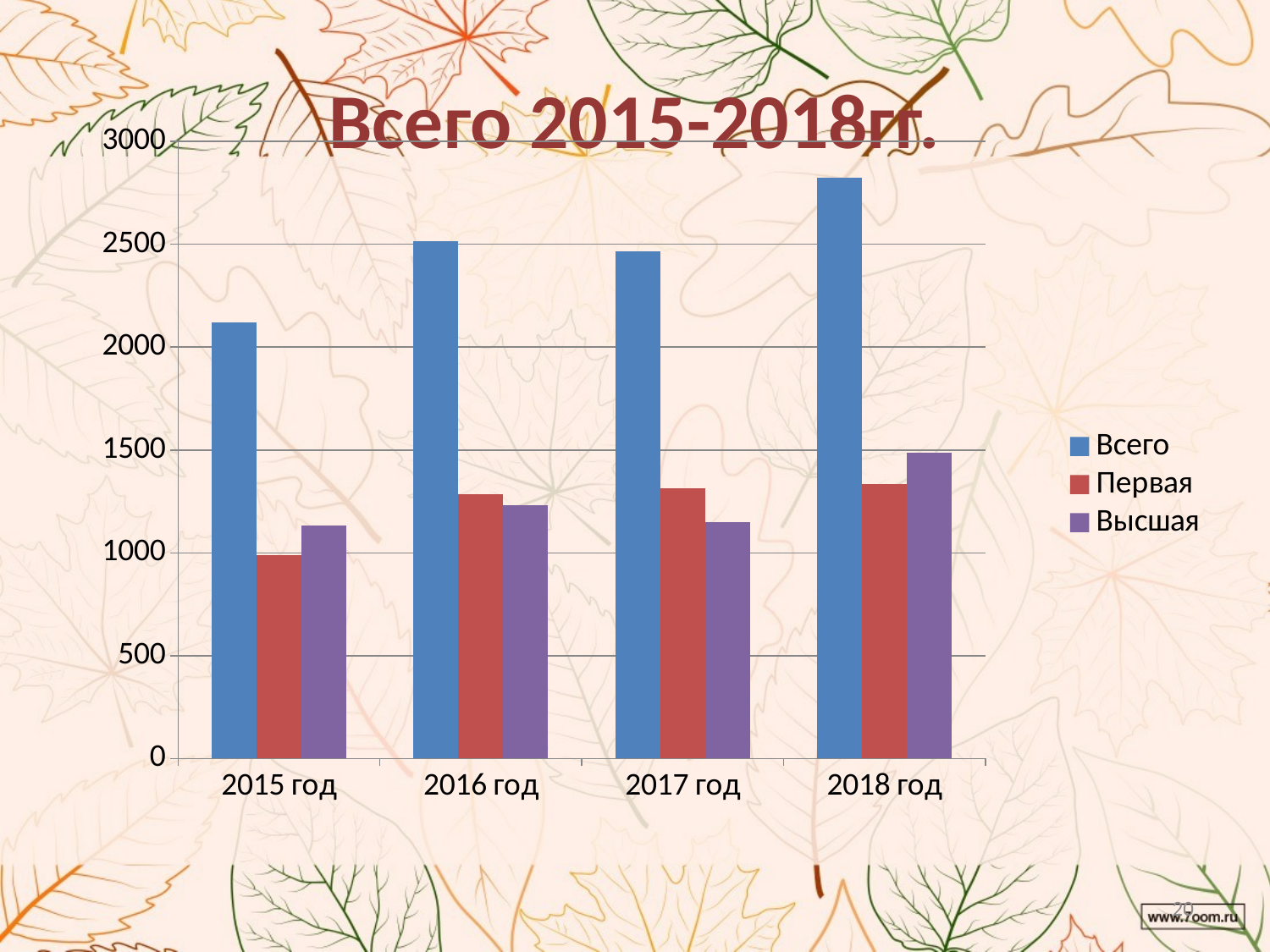
What is the title of the chart? Всего 2015-2018гг. Is the value for Всего in 2015 год greater or less than 2000? greater What kind of chart is shown on the slide? bar chart Which series is shown in blue? Всего How many series does the legend list? 3 In which year is the value for Всего the highest? 2018 год How many year categories are shown on the x axis? 4 In which year is the value for Всего the lowest? 2015 год In which year is the value for Высшая the highest? 2018 год In 2015 год, which is larger: Первая or Высшая? Высшая Is the value for Всего in 2018 год greater or less than 2500? greater